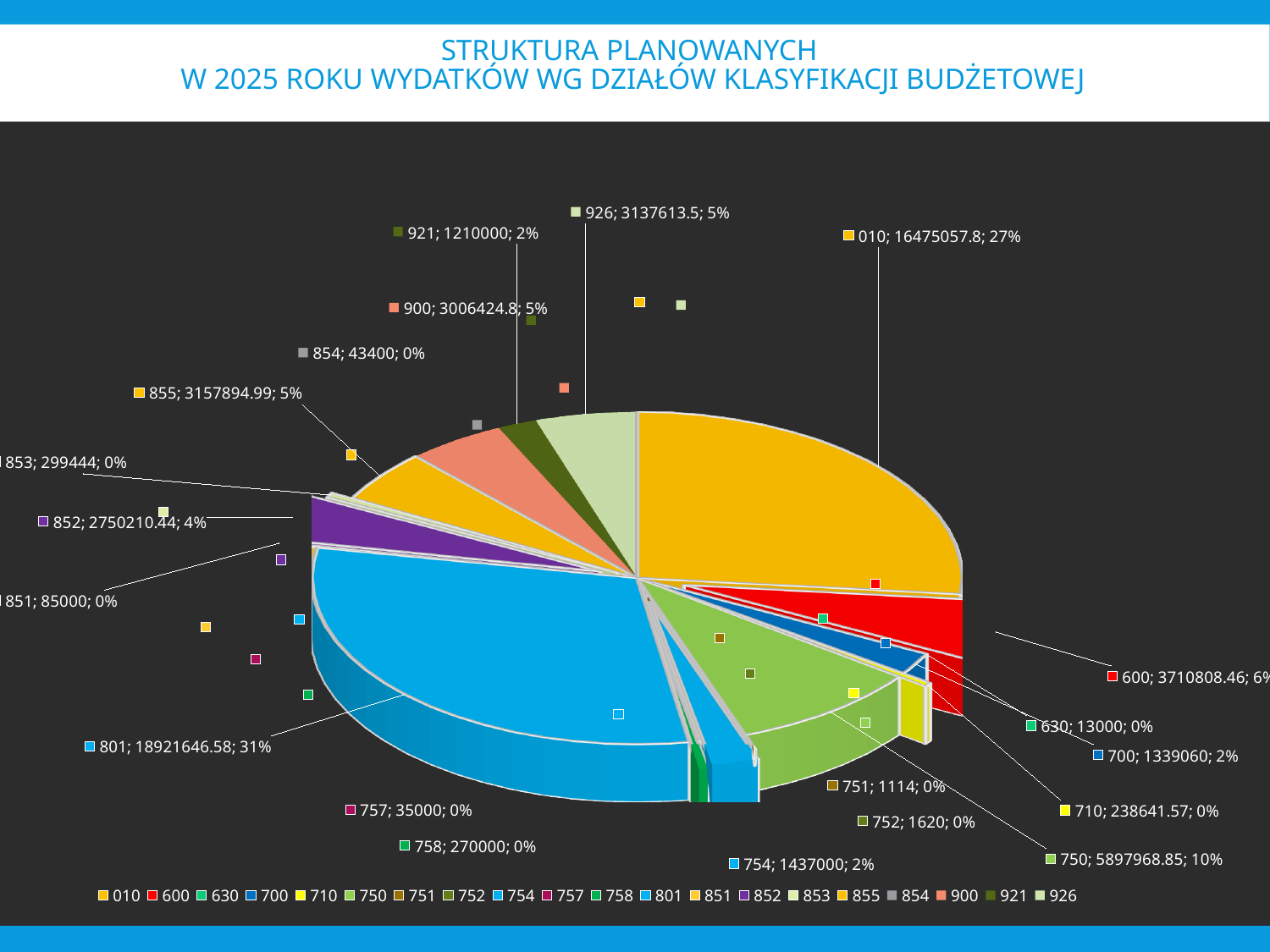
What kind of chart is shown on the slide? pie chart Which category has the smallest value in the pie chart? 751 What is the value shown for category 750? 5897968.85 What is the difference between the values for 801 and 010? 2446588.78 What percentage share does category 600 have? 6% What is the value shown for category 010? 16475057.8 Which category has the largest share of the pie? 801 What is the difference between the values for 754 and 700? 97940 What percentage share does category 801 have? 31% How many categories does the legend list? 20 What is the title of the chart? STRUKTURA PLANOWANYCH W 2025 ROKU WYDATKÓW WG DZIAŁÓW KLASYFIKACJI BUDŻETOWEJ Which is larger, the value for 900 or the value for 926? 926